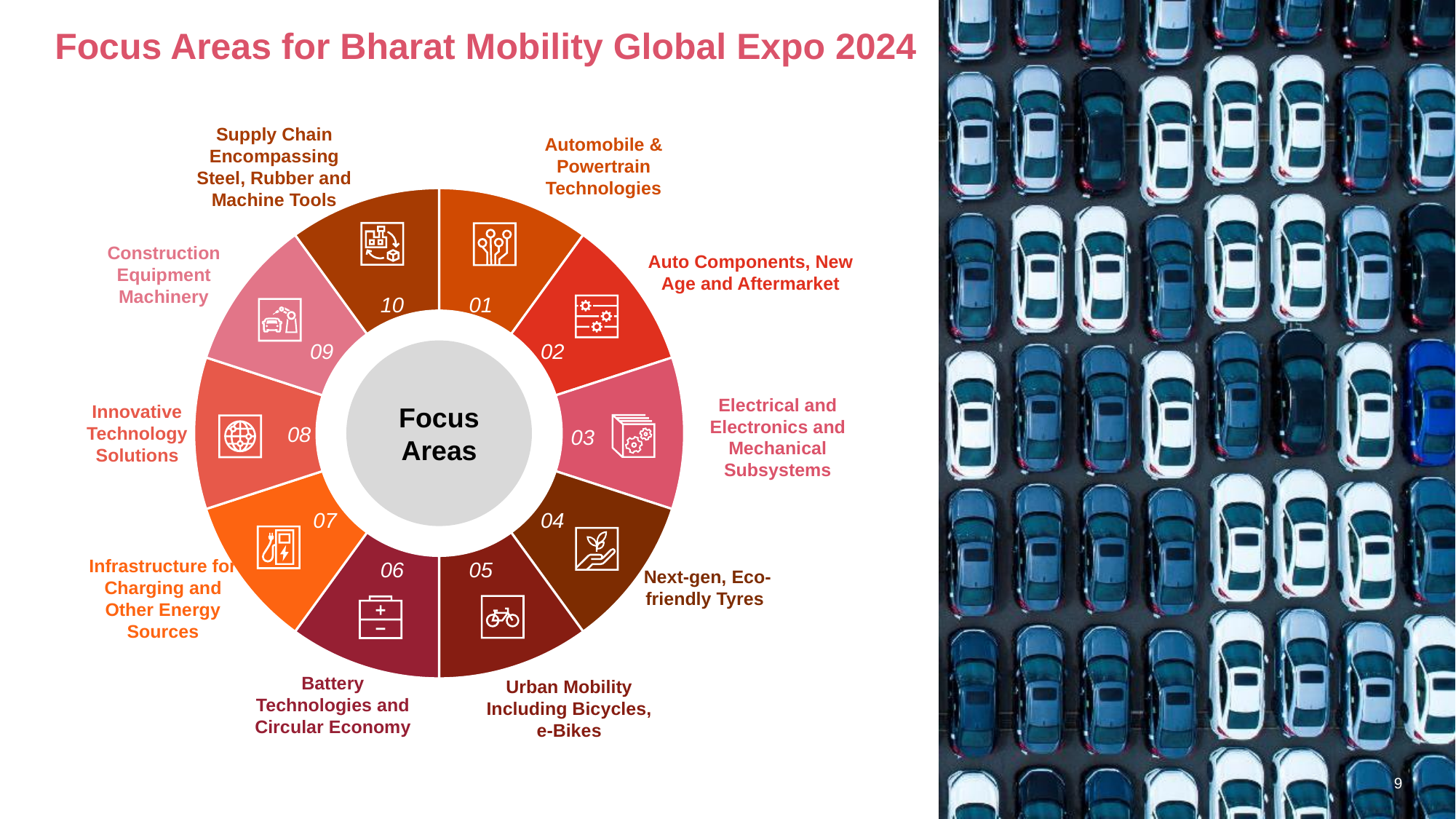
Which focus area is numbered 09 in the donut chart? Construction Equipment Machinery What text appears in the centre of the donut chart? Focus Areas How many segments does the donut chart have? 10 Which focus area is numbered 03 in the donut chart? Electrical and Electronics and Mechanical Subsystems Which focus area is numbered 06 in the donut chart? Battery Technologies and Circular Economy What number is assigned to the segment labelled Infrastructure for Charging and Other Energy Sources? 07 What kind of chart is shown on the slide? Donut chart Which focus area is numbered 01 in the donut chart? Automobile & Powertrain Technologies What number is assigned to the segment labelled Next-gen, Eco-friendly Tyres? 04 What is the title of the slide containing the donut chart? Focus Areas for Bharat Mobility Global Expo 2024 What number is assigned to the segment labelled Supply Chain Encompassing Steel, Rubber and Machine Tools? 10